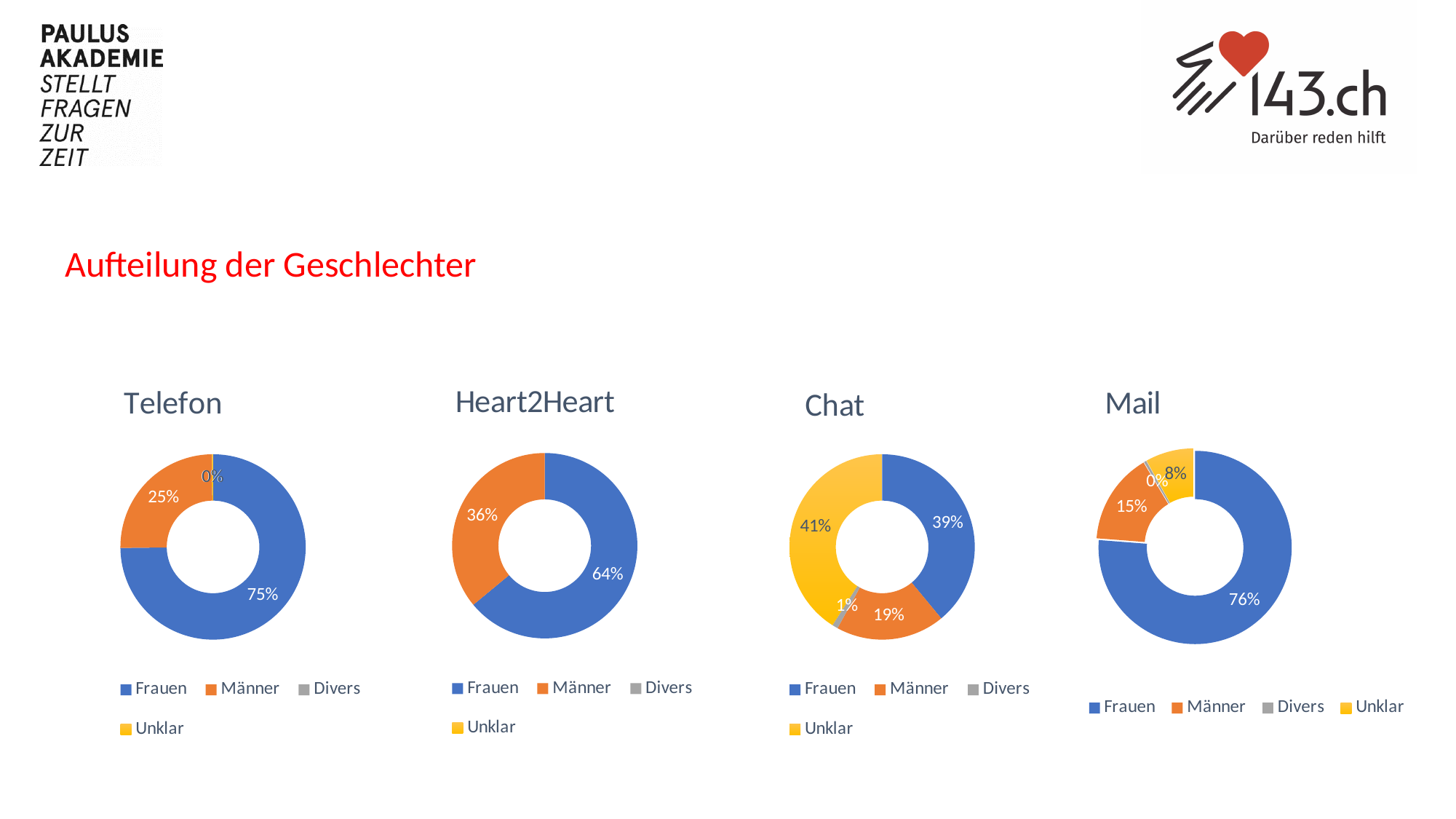
In the Mail chart, which category has the largest share? Frauen In the Telefon chart, what share is labelled for Frauen? 75% In the Heart2Heart chart, what is the difference between the Frauen and Männer shares? 28% What kind of chart is the Telefon chart? Pie (doughnut) chart In the Chat chart, what share is labelled for Unklar? 41% In the Chat chart, which category has the largest share? Unklar In the Mail chart, what share is labelled for Männer? 15% How many charts are shown on the slide? 4 How many entries does the legend of the Mail chart list? 4 In the Heart2Heart chart, what share is labelled for Männer? 36% In the Telefon chart, what share is labelled for Männer? 25% In the Chat chart, which is larger, the share for Frauen or the share for Männer? Frauen